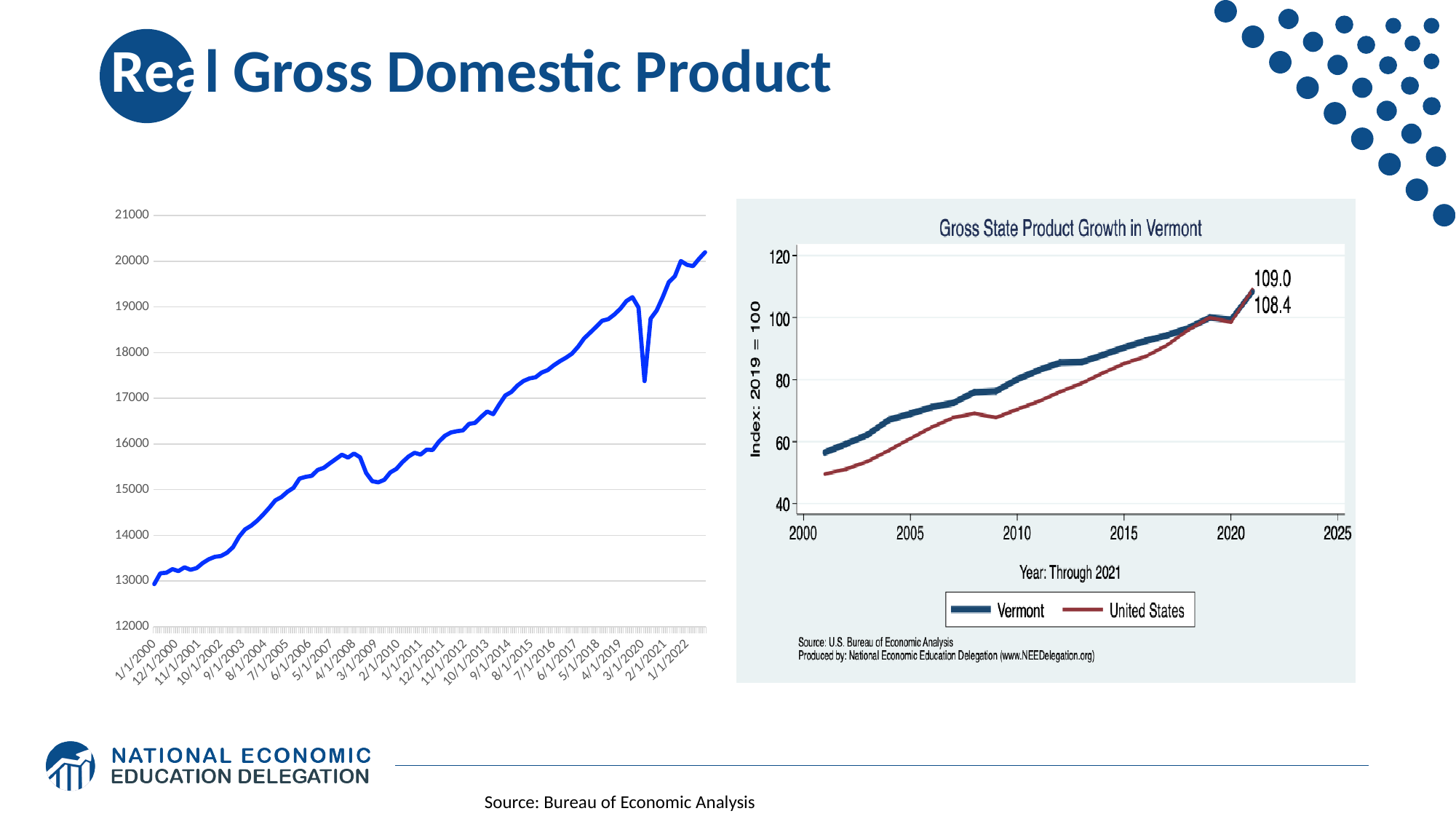
In the left chart, is the value at the sharp dip in 2020 greater or less than 18000? less In the right chart, what is the lower of the two values labeled at the end of the lines in 2021? 108.4 In the right chart, is the value for the United States in 2001 greater or less than 60? less In the right chart, what is the higher of the two values labeled at the end of the lines in 2021? 109.0 What are the two series named in the legend of the right chart? Vermont and United States In the right chart, what is the difference between the two values labeled at the end of the lines (109.0 and 108.4)? 0.6 In the right chart, which series has the higher value in 2010, Vermont or United States? Vermont What kind of chart is the left chart on the slide? line chart What is the title of the right chart? Gross State Product Growth in Vermont In the left chart, do the values generally rise or fall from 2000 to 2022? rise How many series does the legend of the right chart list? 2